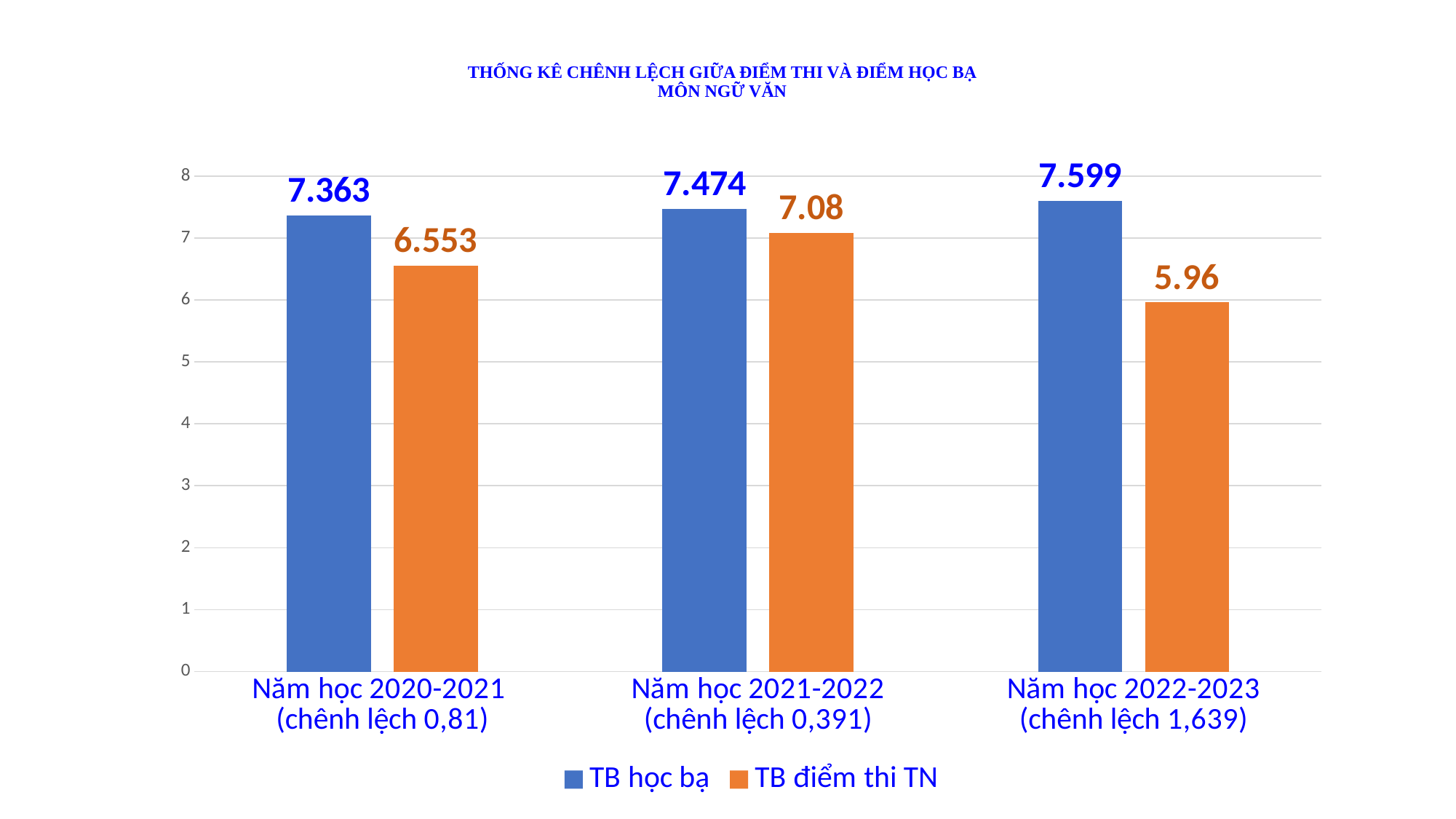
Which is larger for Năm học 2021-2022: TB học bạ or TB điểm thi TN? TB học bạ What is the value of TB học bạ for Năm học 2020-2021? 7.363 How many school years are shown on the x axis? 3 What is the difference between TB học bạ and TB điểm thi TN for Năm học 2022-2023? 1.639 How many series does the legend list? 2 What is the value of TB điểm thi TN for Năm học 2022-2023? 5.96 What is the difference between TB học bạ and TB điểm thi TN for Năm học 2020-2021? 0.81 Does the TB học bạ value rise or fall from Năm học 2020-2021 to Năm học 2022-2023? Rise What kind of chart is shown on the slide? Bar chart Which school year has the highest TB học bạ value? Năm học 2022-2023 Which school year has the lowest TB điểm thi TN value? Năm học 2022-2023 What is the value of TB điểm thi TN for Năm học 2021-2022? 7.08